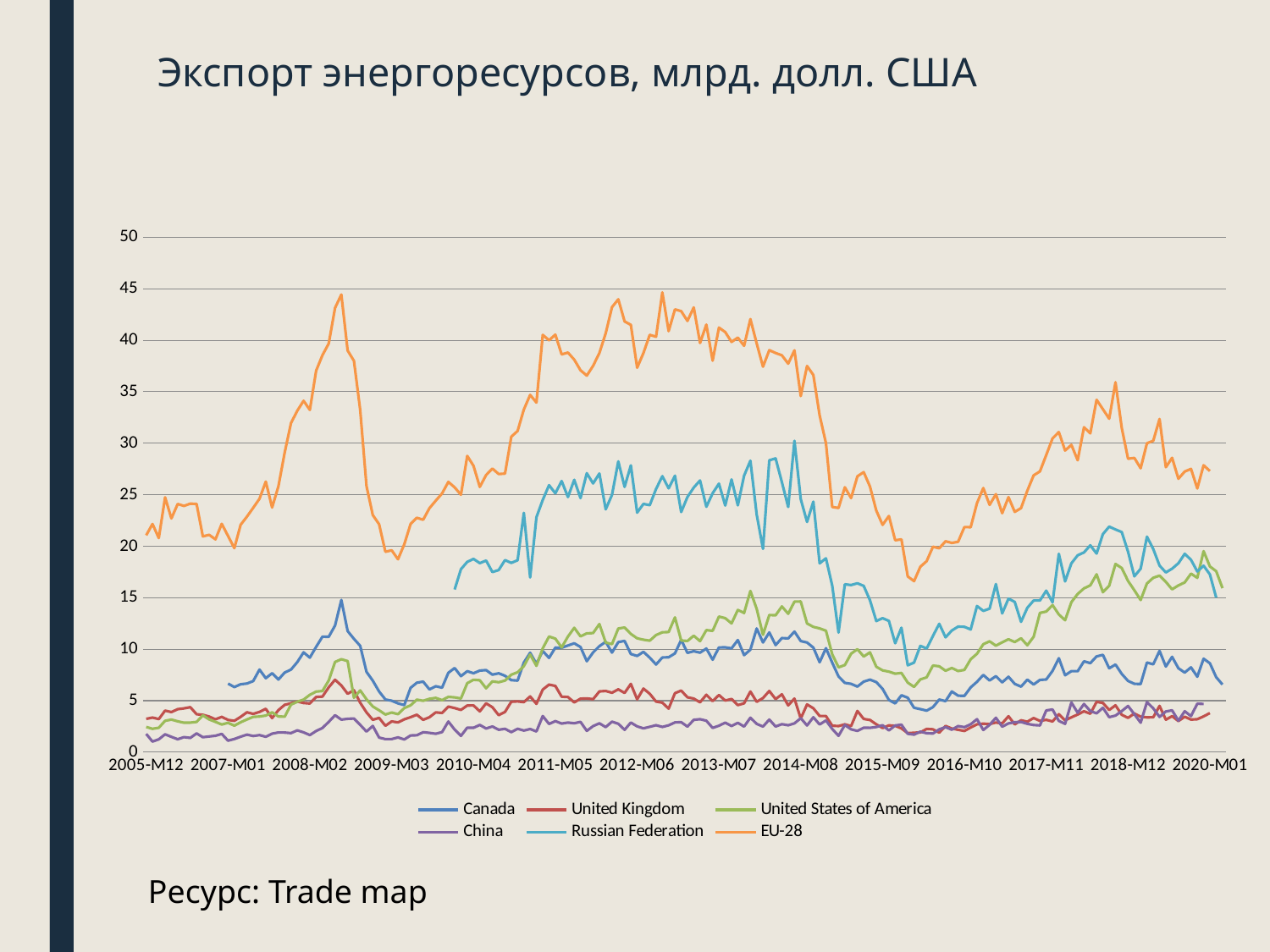
What kind of chart is shown on the slide? line chart How many series does the legend list? 6 Is the value for United States of America at 2020-M01 greater or less than 15? greater Is the value for EU-28 at 2012-M06 greater or less than 40? less Which series reaches the highest values on the chart? EU-28 Which series stays lowest across the chart? China How many labels are shown on the x axis? 14 Is the value for Russian Federation at 2015-M09 greater or less than 15? less What is the title of the chart? Экспорт энергоресурсов, млрд. долл. США At 2013-M07, which is larger: Russian Federation or United States of America? Russian Federation Does the EU-28 line rise or fall between 2014-M08 and 2015-M09? fall